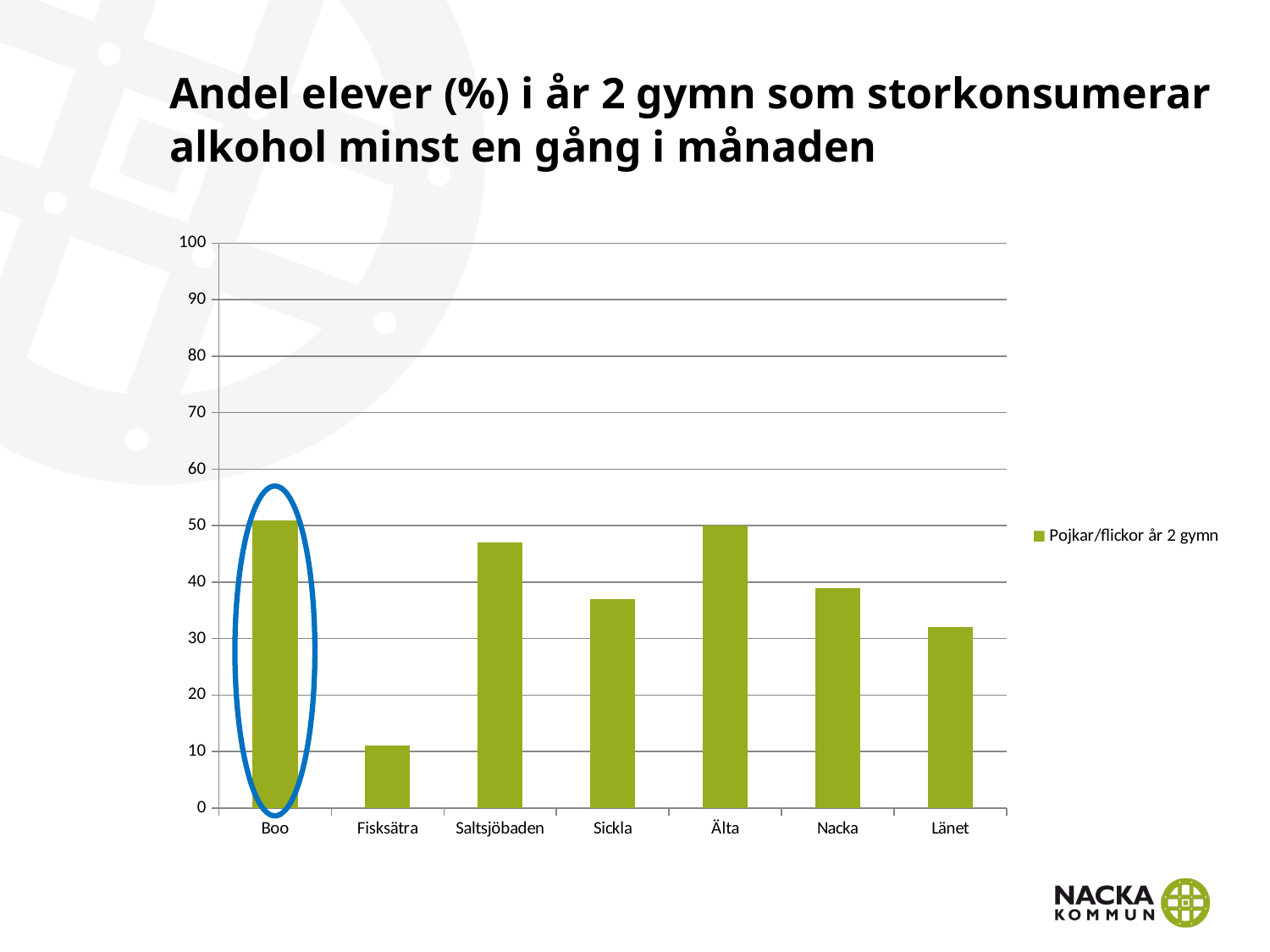
Is the value for Länet greater or less than 40? less What is the name of the series listed in the legend? Pojkar/flickor år 2 gymn Which is larger, the value for Saltsjöbaden or the value for Sickla? Saltsjöbaden Which is larger, the value for Nacka or the value for Länet? Nacka Which category's bar is circled in blue on the chart? Boo How many categories are shown on the x axis of the chart? 7 How many series does the legend list? 1 Is the value for Fisksätra greater or less than 20? less Is the value for Saltsjöbaden greater or less than 40? greater What kind of chart is shown on the slide? Bar chart Which category has the lowest value in the chart? Fisksätra